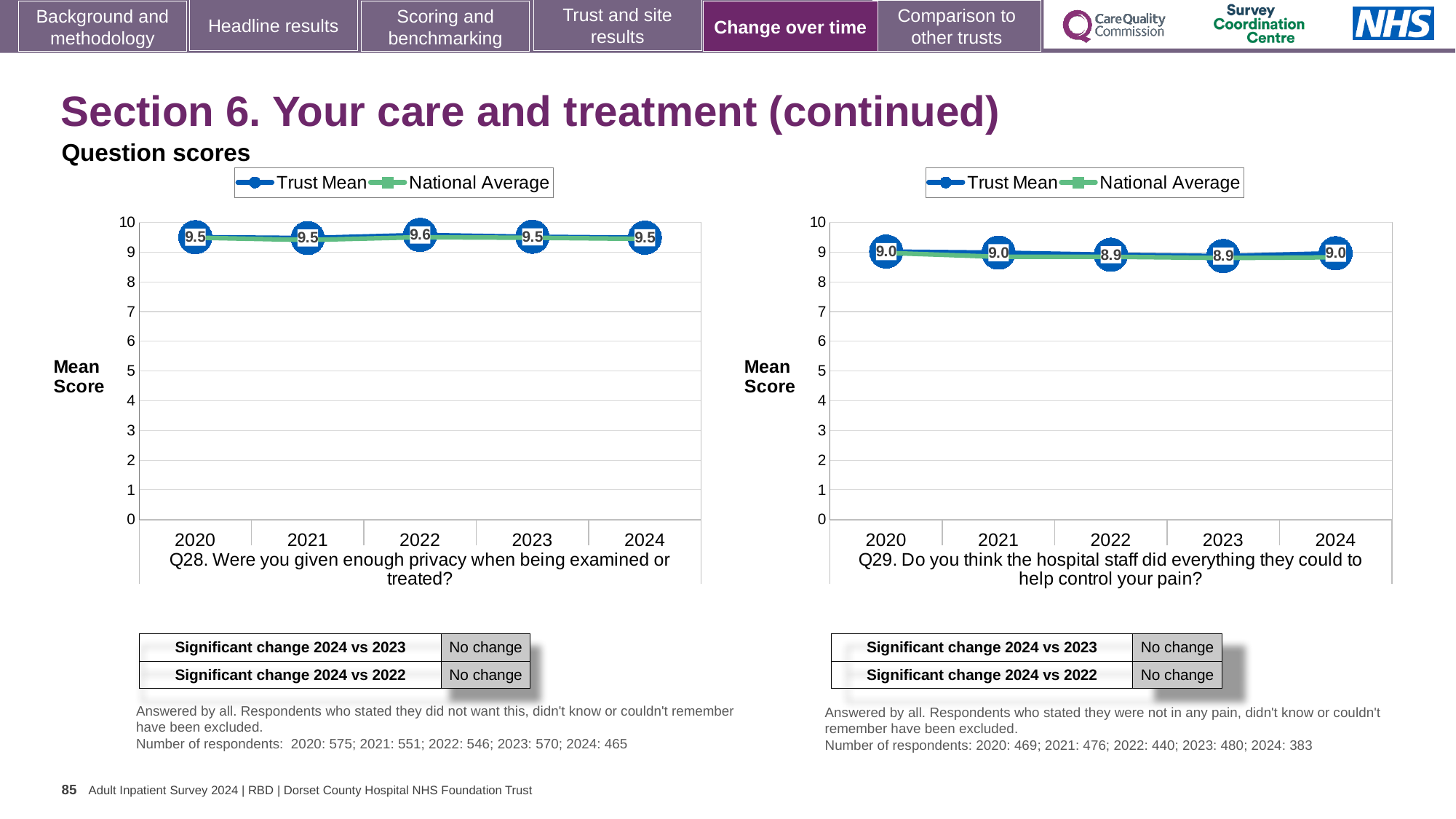
On the Q29 chart (right), what is the difference between the Trust Mean scores for 2020 and 2022? 0.1 On the Q29 chart (right), what is the Trust Mean score for 2022? 8.9 What are the two series named in the legend of the Q28 chart (left)? Trust Mean and National Average On the Q28 chart (left), what is the difference between the Trust Mean scores for 2022 and 2023? 0.1 On the Q28 chart (left), which year has the highest Trust Mean score? 2022 How many series does the legend of the Q29 chart (right) list? 2 On the Q28 chart (left), what is the Trust Mean score for 2022? 9.6 How many years are plotted on the Q28 chart (left)? 5 On the Q28 chart (left), what is the Trust Mean score for 2020? 9.5 What type of chart is used for Q28 (left)? Line chart On the Q29 chart (right), is the National Average value for 2021 greater or less than 8? greater On the Q29 chart (right), what is the Trust Mean score for 2024? 9.0